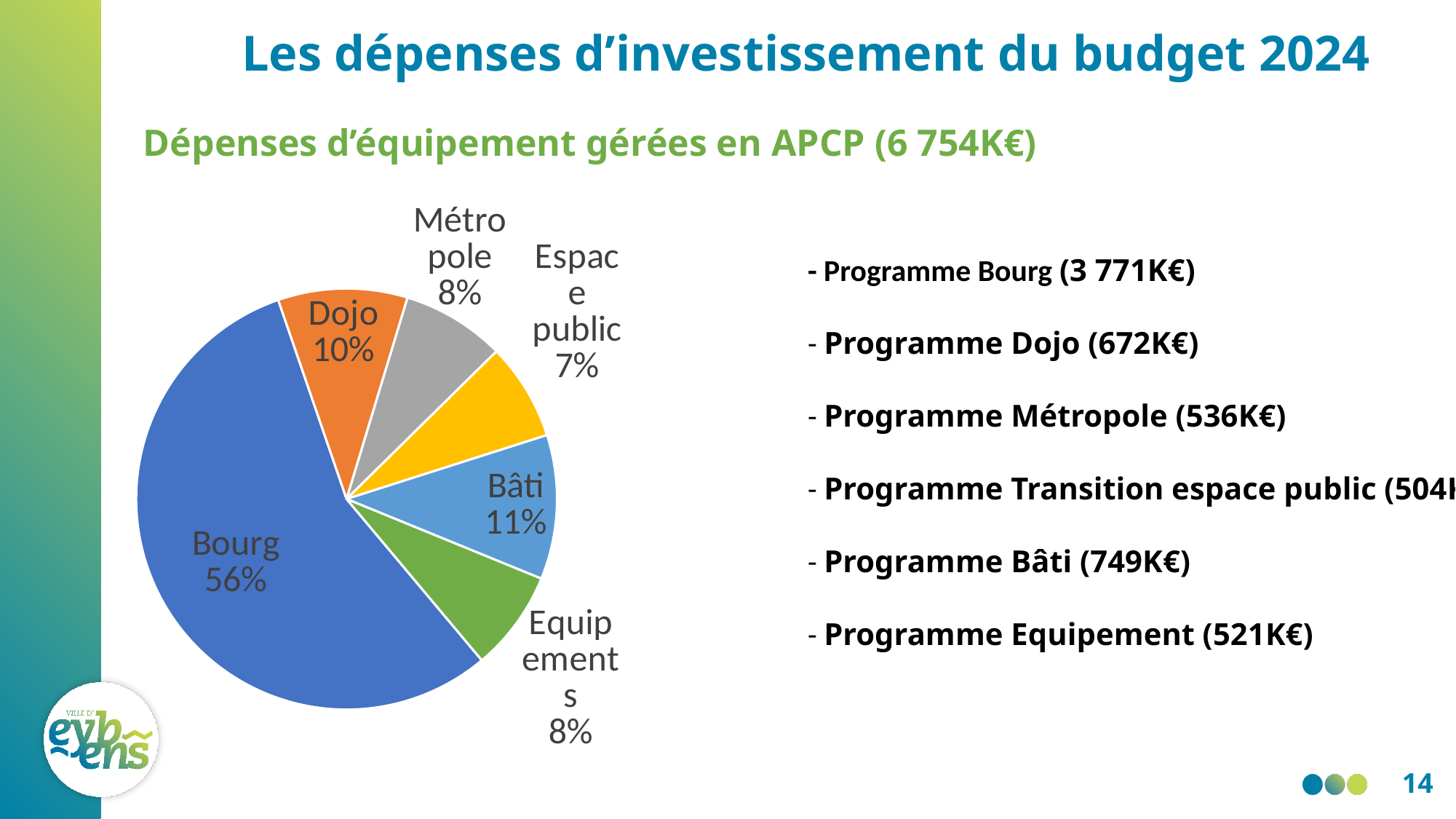
Which slice of the pie is the largest? Bourg What colour is the Bourg slice of the pie chart? blue What percentage is shown for the Métropole slice? 8% Which slice of the pie is the smallest? Espace public What share of the pie does the Bourg slice represent? 56% What percentage is shown for the Espace public slice? 7% How many slices does the pie chart have? 6 What percentage is shown for the Dojo slice? 10% What percentage is shown for the Bâti slice? 11% What kind of chart is shown on the slide? pie chart What is the difference in percentage points between the Bourg slice and the Bâti slice? 45% Which is larger, the Dojo slice or the Equipements slice? Dojo